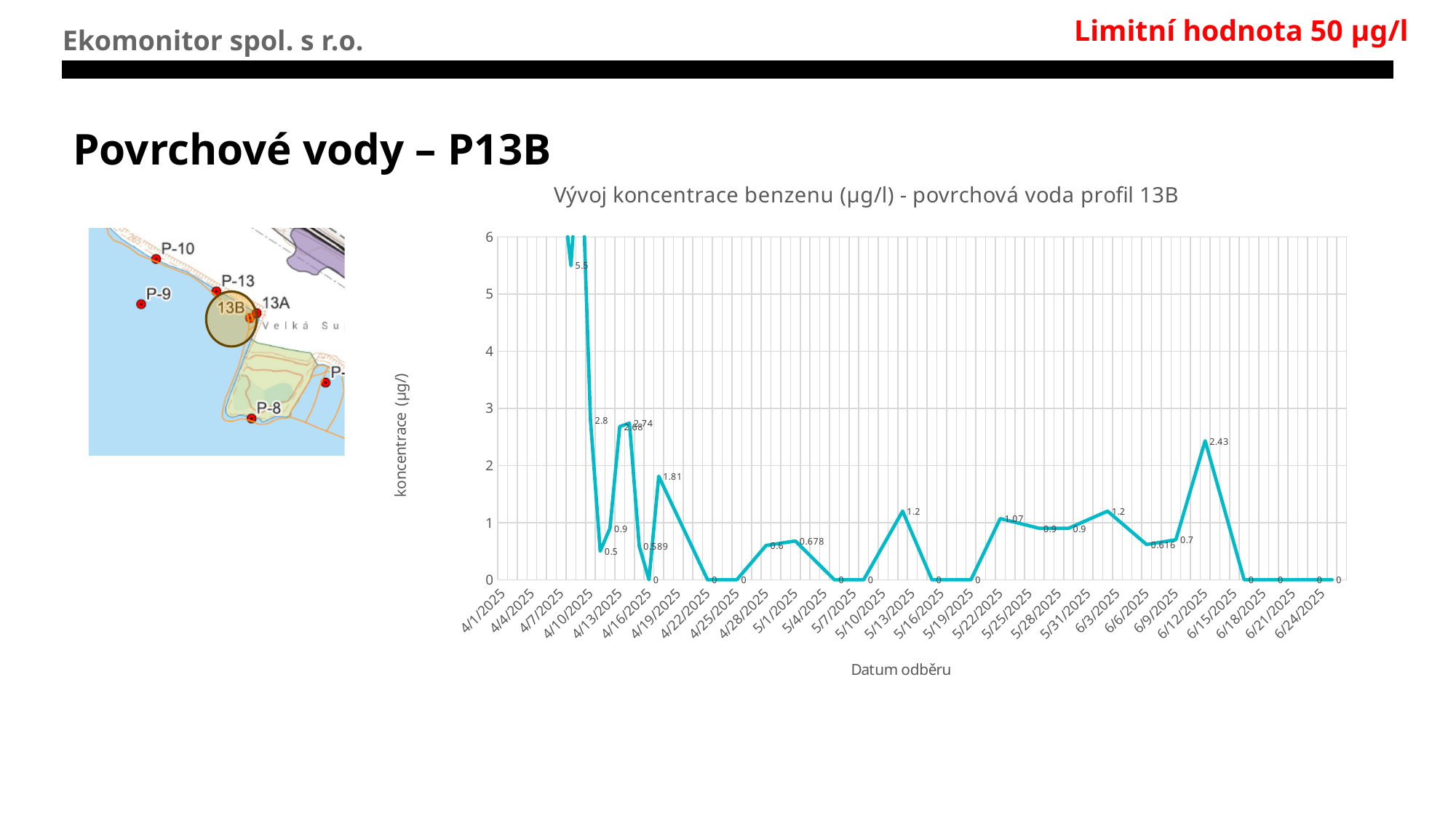
Is the value at the June 2025 peak greater or less than 2? greater What kind of chart is shown on the slide? line chart What is the value at the peak between 5/10/2025 and 5/16/2025? 1.2 What is the difference between the June 2025 peak (2.43) and the mid-May peak (1.2)? 1.23 Is the value at the peak near 4/19/2025 greater or less than 2? less Which is larger: the June 2025 peak value or the peak value near 4/19/2025? the June 2025 peak (2.43) What is the value of the last data point on the chart? 0 Do the concentration values generally rise or fall from early April to late June 2025? fall What is the highest value reached in June 2025 on the chart? 2.43 What is the lowest value plotted on the chart? 0 What is the title of the chart? Vývoj koncentrace benzenu (µg/l) - povrchová voda profil 13B What is the label of the vertical axis of the chart? koncentrace (µg/l)